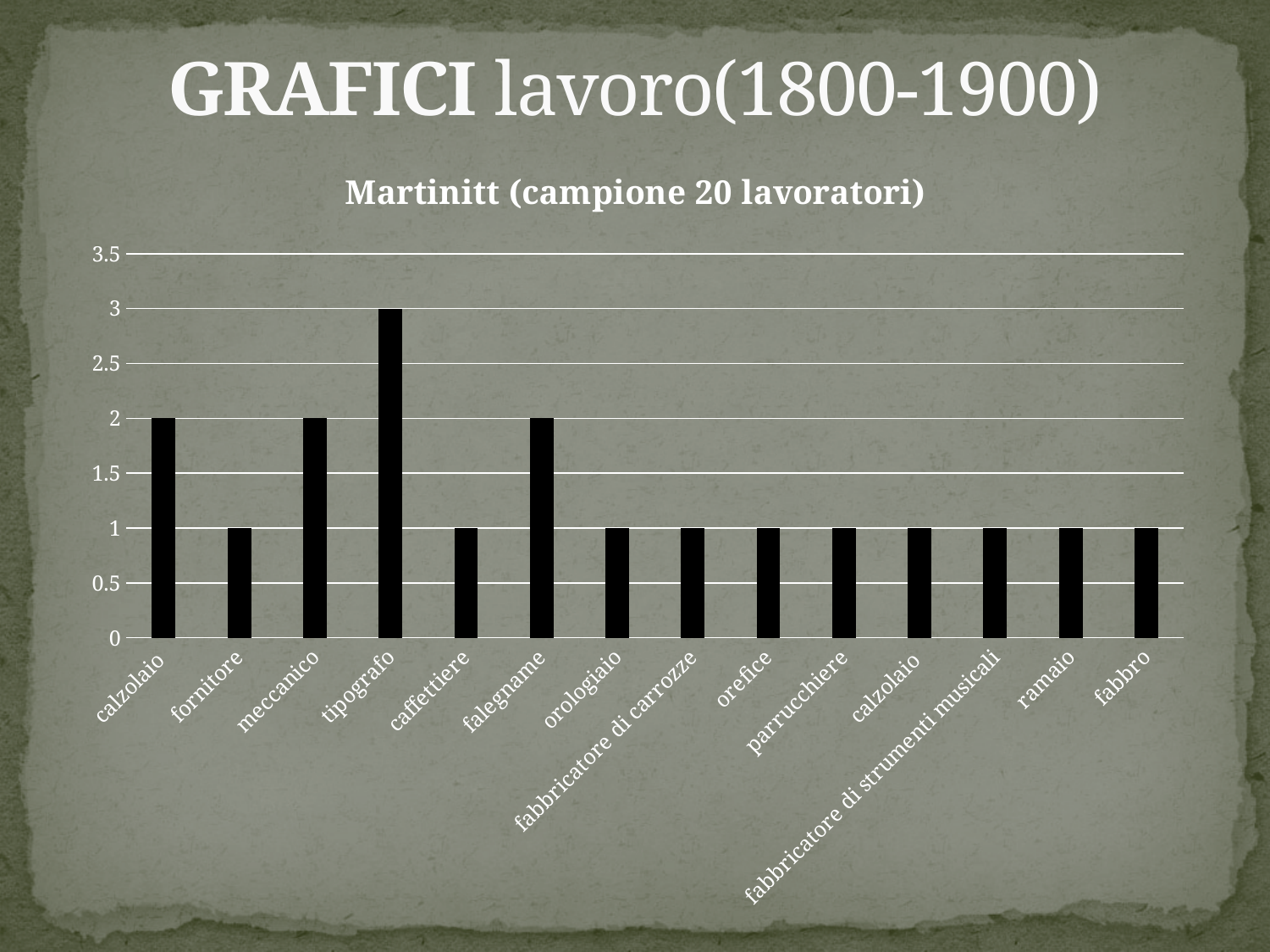
What is the value for meccanico? 2 What is the value for fornitore? 1 What is the title of the chart? Martinitt (campione 20 lavoratori) What is the value for tipografo? 3 What is the value for falegname? 2 What is the difference between the values for tipografo and orefice? 2 What is the value for fabbro? 1 How many categories are shown on the x axis? 14 What kind of chart is shown on the slide? bar chart Which is larger, the value for meccanico or the value for parrucchiere? meccanico Is the value for tipografo greater or less than 2.5? greater Which category has the highest value? tipografo